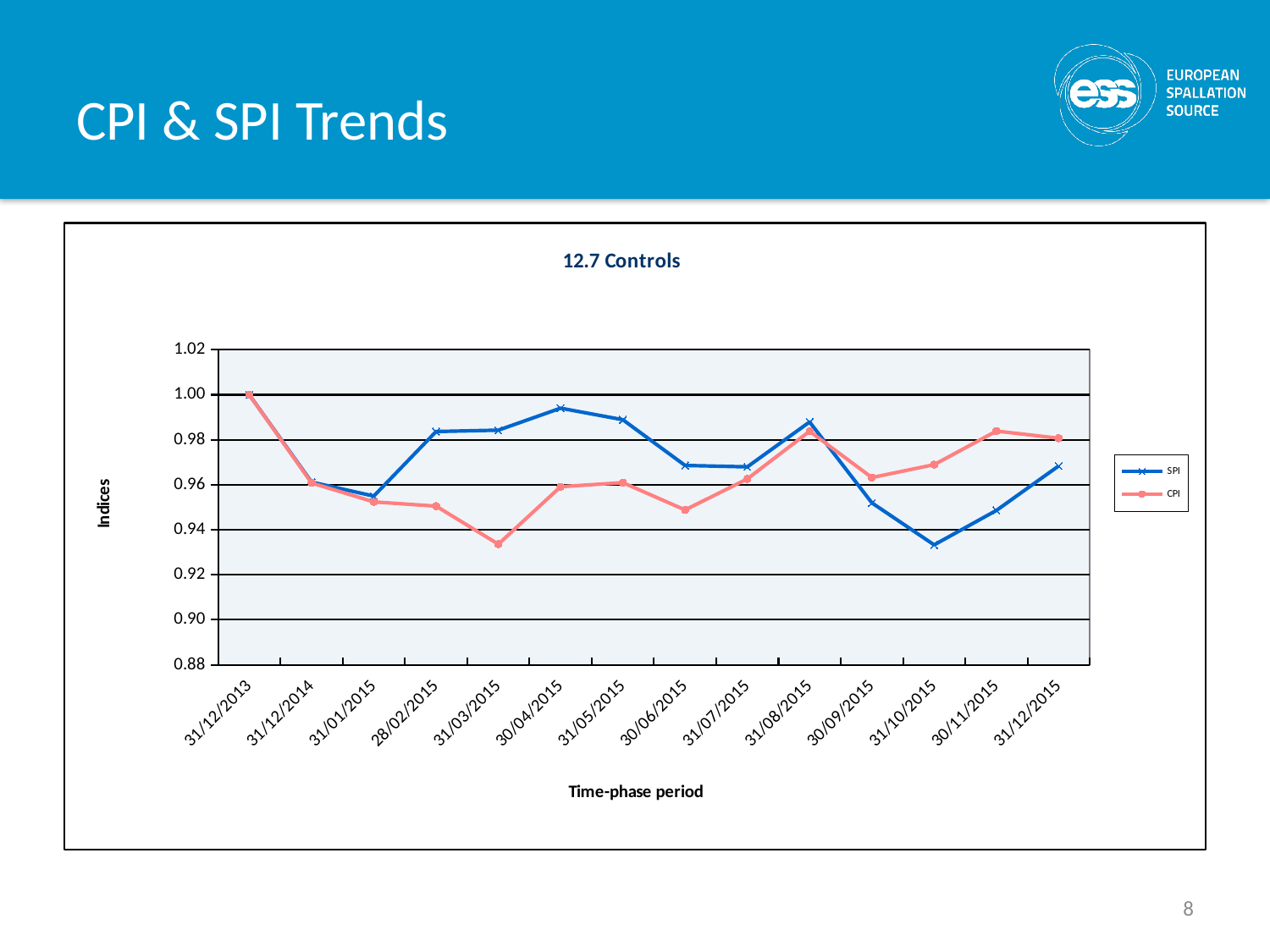
What is the SPI value at 31/12/2013? 1.00 How many series does the legend list? 2 What kind of chart is shown on the slide? Line chart How many time-phase periods are plotted along the x axis? 14 What is the title of the chart? 12.7 Controls At 31/03/2015, which series has the larger value, SPI or CPI? SPI Is the CPI value at 30/06/2015 greater or less than 0.96? less At which time-phase period is the CPI series lowest? 31/03/2015 At which time-phase period is the SPI series lowest? 31/10/2015 Is the SPI value at 30/04/2015 greater or less than 0.98? greater What is the label of the y axis? Indices Does the SPI series rise or fall from 31/08/2015 to 31/10/2015? Fall